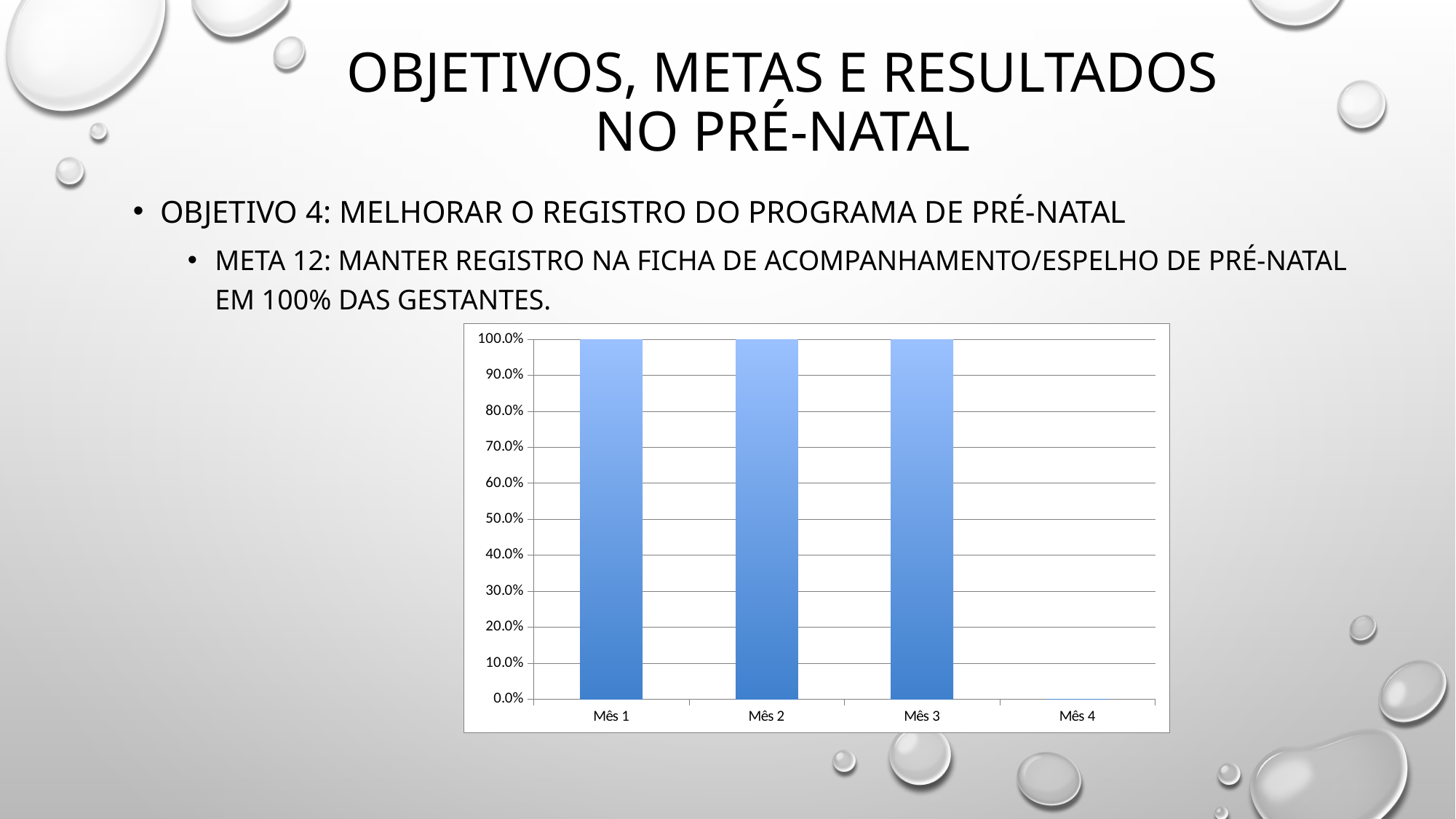
What is the value for Mês 3? 100.0% Is the value for Mês 2 greater or less than 50.0%? greater Is the value for Mês 4 greater or less than 10.0%? less What is the value for Mês 4? 0.0% What is the value for Mês 1? 100.0% Which is larger, the value for Mês 2 or the value for Mês 4? Mês 2 What is the difference between the value for Mês 1 and the value for Mês 4? 100.0% What is the label of the first category on the x axis? Mês 1 What is the highest value shown on the y axis? 100.0% What kind of chart is shown on the slide? bar chart Which category has the lowest value? Mês 4 How many categories are shown on the x axis? 4